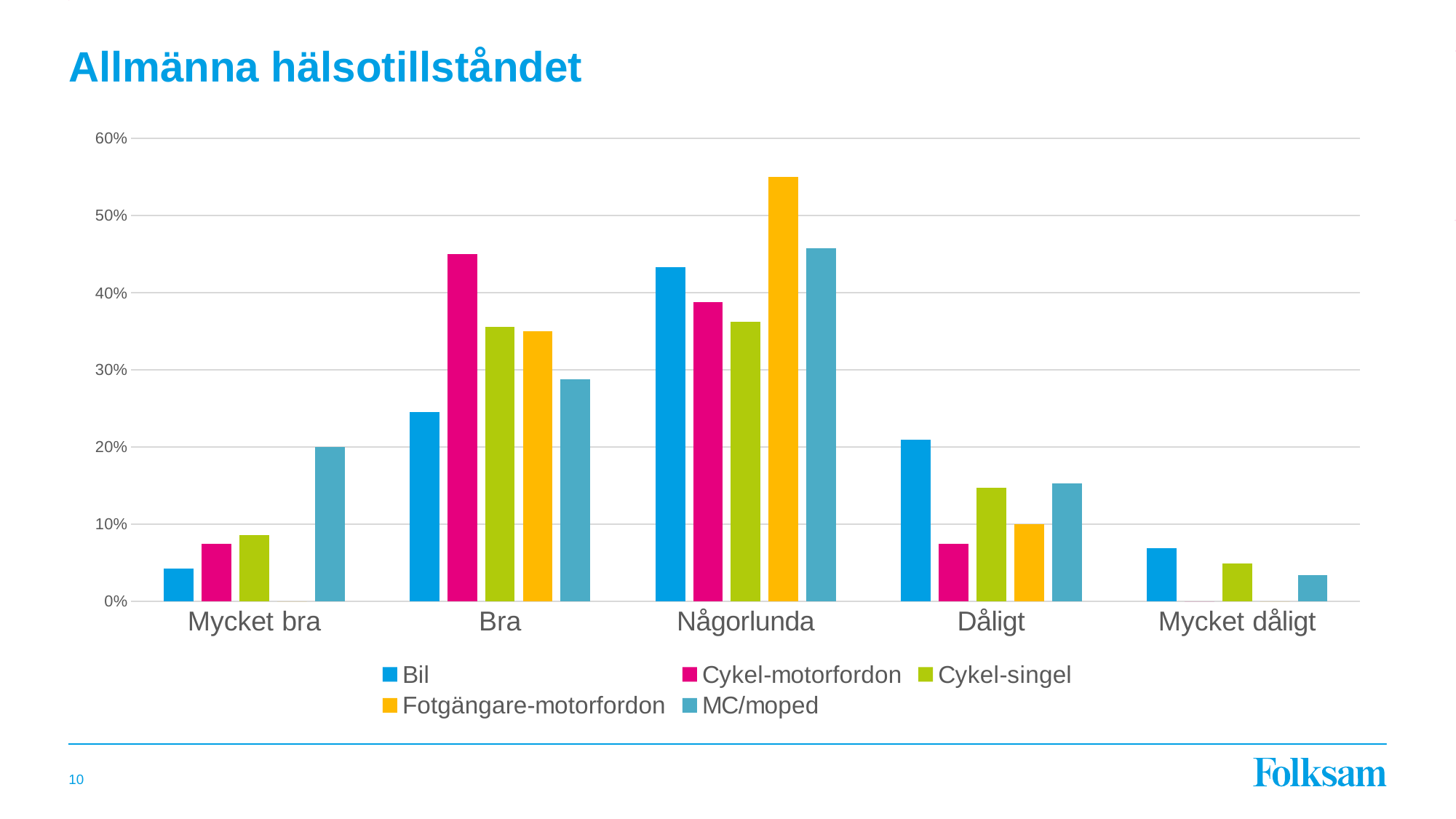
Is the value for Cykel-motorfordon in the Bra category greater or less than 40%? greater Which series has the highest value in the Någorlunda category? Fotgängare-motorfordon Is the value for Fotgängare-motorfordon in the Någorlunda category greater or less than 50%? greater What is the title of the chart? Allmänna hälsotillståndet What kind of chart is shown on the slide? Bar chart Which series has the highest value in the Bra category? Cykel-motorfordon Is the value for Bil in the Någorlunda category greater or less than 40%? greater Which series has the highest value in the Mycket bra category? MC/moped In the Dåligt category, which is larger: Bil or Cykel-motorfordon? Bil How many series does the legend list? 5 Which series has the lowest value in the Dåligt category? Cykel-motorfordon How many categories are shown on the x axis? 5